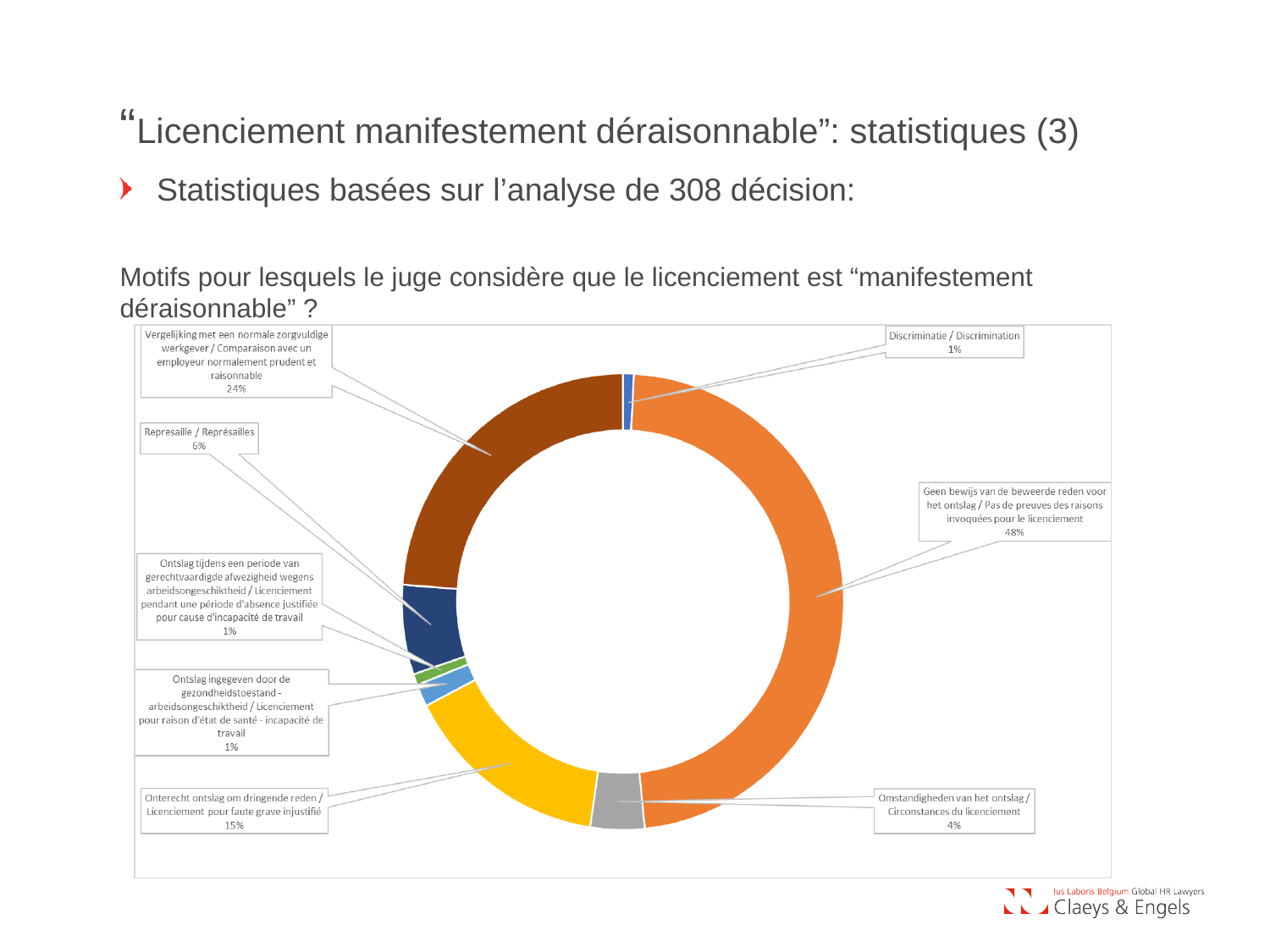
What percentage is shown for "Onterecht ontslag om dringende reden / Licenciement pour faute grave injustifié"? 15% What kind of chart is shown on the slide? Doughnut chart What is the difference in percentage points between "Geen bewijs van de beweerde reden voor het ontslag" (48%) and "Vergelijking met een normale zorgvuldige werkgever" (24%)? 24 percentage points What percentage is shown for "Discriminatie / Discrimination"? 1% Which is larger: the share for "Represaille / Représailles" or the share for "Omstandigheden van het ontslag / Circonstances du licenciement"? Represaille / Représailles How many categories are shown in the chart? 8 How many categories in the chart are labelled 1%? 3 What is the combined share of "Onterecht ontslag om dringende reden" (15%) and "Represaille / Représailles" (6%)? 21% What percentage is shown for "Represaille / Représailles"? 6% What percentage is shown for "Omstandigheden van het ontslag / Circonstances du licenciement"? 4% Which category has the largest share of the chart? Geen bewijs van de beweerde reden voor het ontslag / Pas de preuves des raisons invoquées pour le licenciement What share of the chart is labelled "Geen bewijs van de beweerde reden voor het ontslag / Pas de preuves des raisons invoquées pour le licenciement"? 48%